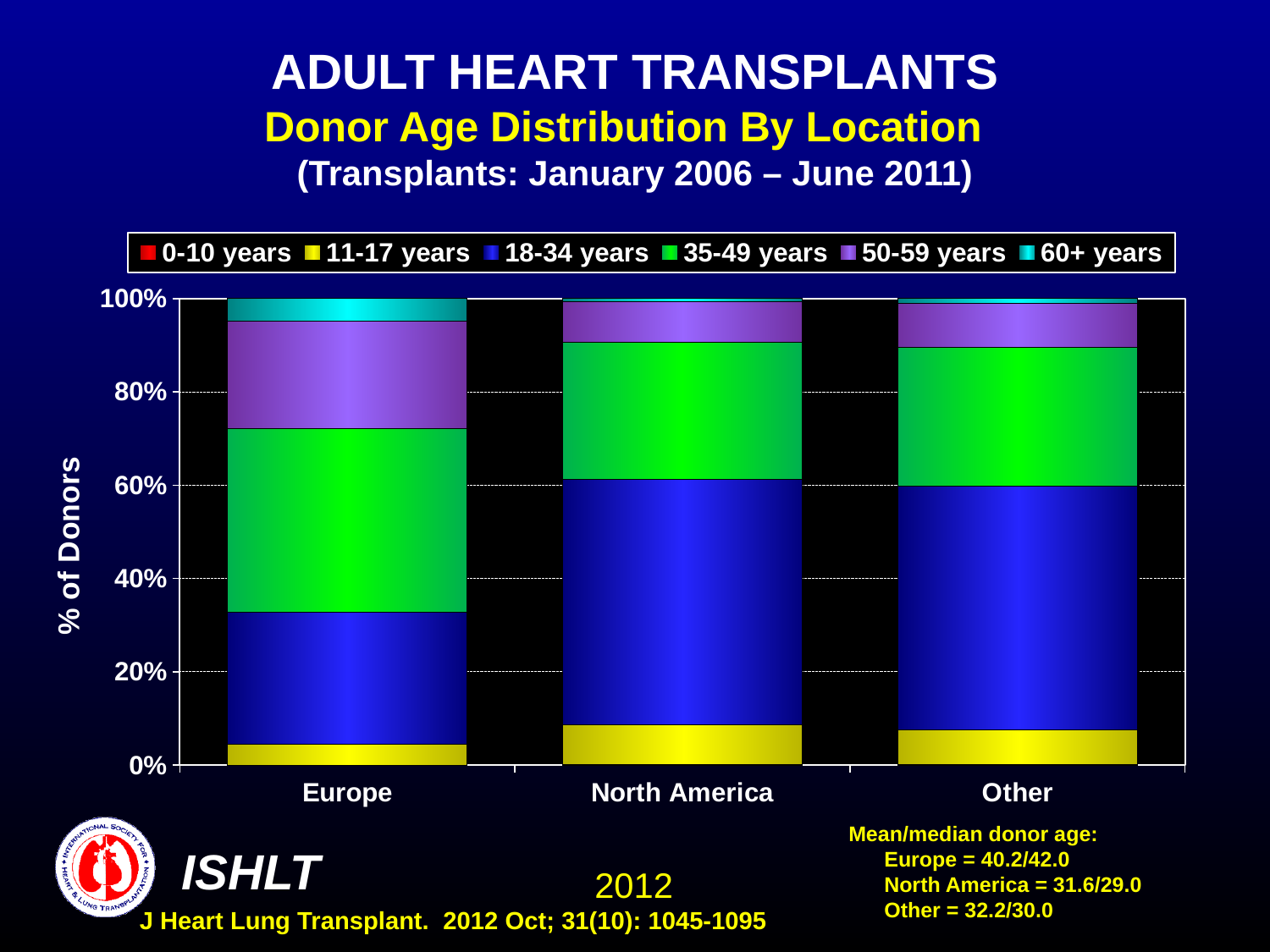
What kind of chart is shown on the slide? Stacked bar chart Is the share of donors aged 50-59 years in Europe greater or less than 10%? greater Which location has the smallest share of donors aged 18-34 years? Europe What transplant period does the chart subtitle state? January 2006 – June 2011 Is the share of donors aged 18-34 years in North America greater or less than 40%? greater Is the share of donors aged 18-34 years in Europe greater or less than 40%? less Which location has the largest share of donors aged 50-59 years? Europe Which has a larger share of donors aged 50-59 years, Europe or Other? Europe What is the label of the y axis of the chart? % of Donors How many locations are shown on the x axis of the chart? 3 How many donor age groups does the legend list? 6 Which has a larger share of donors aged 18-34 years, Europe or North America? North America